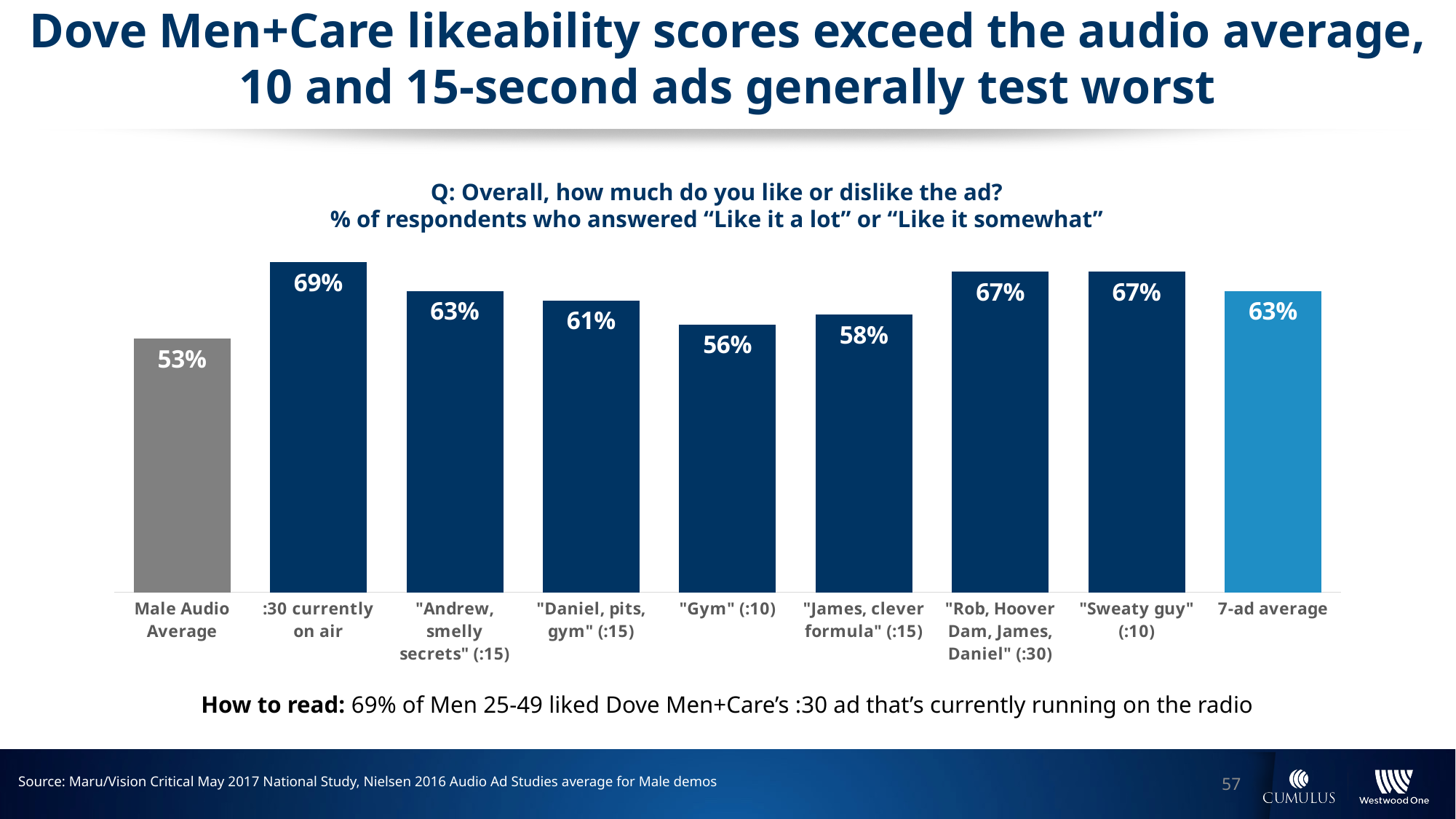
What is the likeability score for the Male Audio Average? 53% Which category has the highest likeability score? :30 currently on air How many bars are shown in the chart? 9 What colour is the bar for the Male Audio Average? Gray Which category has the lowest likeability score? Male Audio Average What is the value shown for the 7-ad average? 63% What is the likeability score for the ":30 currently on air" ad? 69% What is the difference between the 7-ad average and the Male Audio Average? 10% Which is larger, the score for "James, clever formula" (:15) or the score for "Sweaty guy" (:10)? "Sweaty guy" (:10) What is the likeability score for the "Gym" (:10) ad? 56% What type of chart is shown on the slide? Bar chart What is the difference between the ":30 currently on air" score and the Male Audio Average? 16%